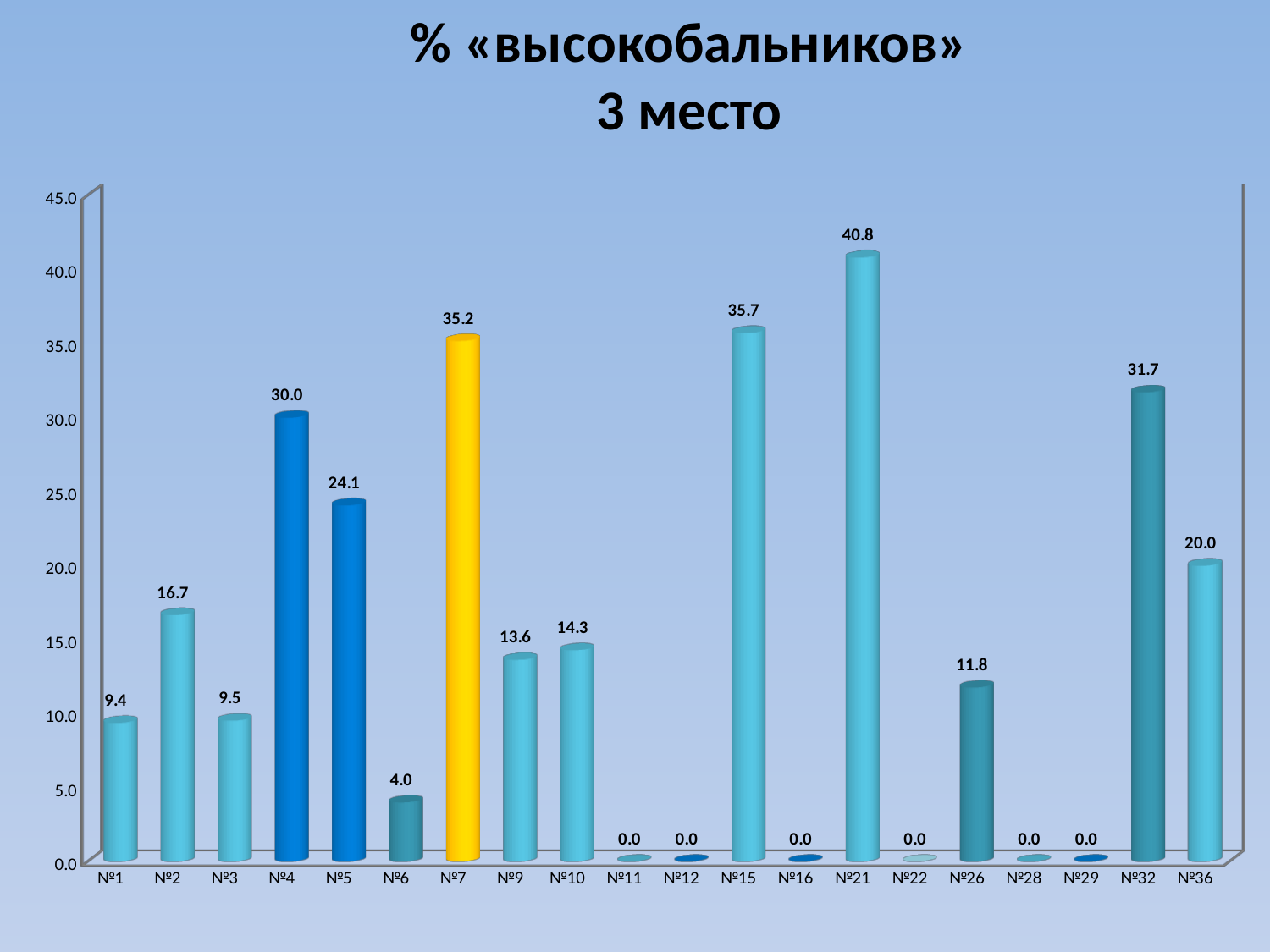
What kind of chart is shown on the slide? bar chart How many categories are shown on the x axis? 20 Is the value for №32 greater or less than 30.0? greater Which category has the highest value? №21 Which is larger, the value for №2 or the value for №3? №2 What is the difference between the values for №21 and №15? 5.1 How many categories have a value of 0.0? 6 What is the value for №26? 11.8 What is the value for №7? 35.2 What is the difference between the values for №4 and №5? 5.9 Which is larger, the value for №32 or the value for №36? №32 What is the value for №21? 40.8